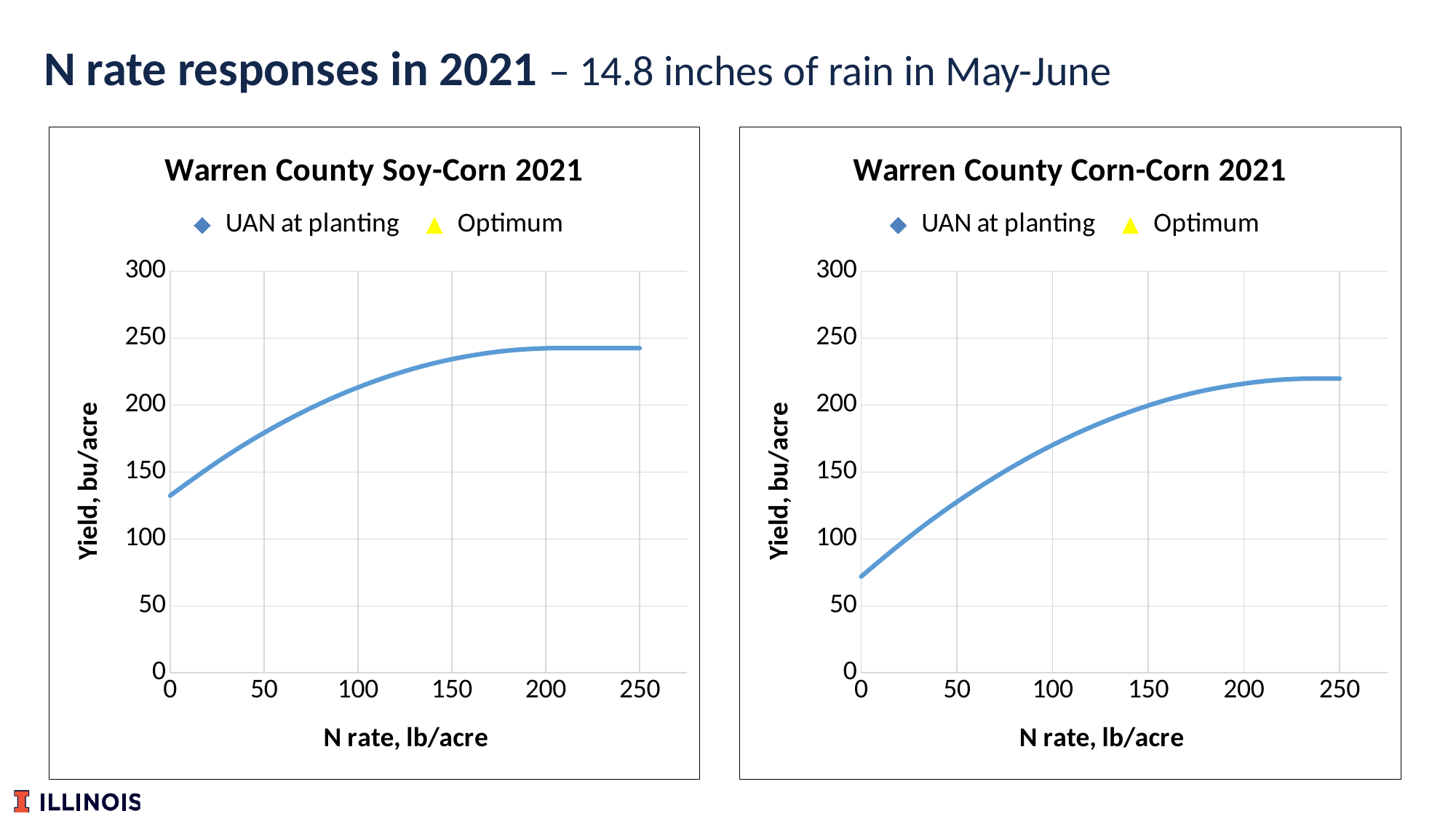
In the Warren County Soy-Corn 2021 chart, is the yield at an N rate of 250 greater or less than 200 bu/acre? greater What is the label of the y axis on the Warren County Corn-Corn 2021 chart? Yield, bu/acre How many series does the legend of the Warren County Corn-Corn 2021 chart list? 2 In the Warren County Corn-Corn 2021 chart, is the yield at an N rate of 250 greater or less than 250 bu/acre? less In the Warren County Corn-Corn 2021 chart, does yield rise or fall as N rate increases from 0 to 200 lb/acre? rise What is the title of the chart on the left of the slide? Warren County Soy-Corn 2021 In the Warren County Corn-Corn 2021 chart, is the yield at an N rate of 0 greater or less than 100 bu/acre? less What kind of chart is the Warren County Soy-Corn 2021 chart? line chart At an N rate of 0, which chart shows the higher yield: Warren County Soy-Corn 2021 or Warren County Corn-Corn 2021? Warren County Soy-Corn 2021 At an N rate of 250, which chart shows the higher yield: Warren County Soy-Corn 2021 or Warren County Corn-Corn 2021? Warren County Soy-Corn 2021 In the Warren County Soy-Corn 2021 chart, does yield rise or fall as N rate increases from 0 to 150 lb/acre? rise